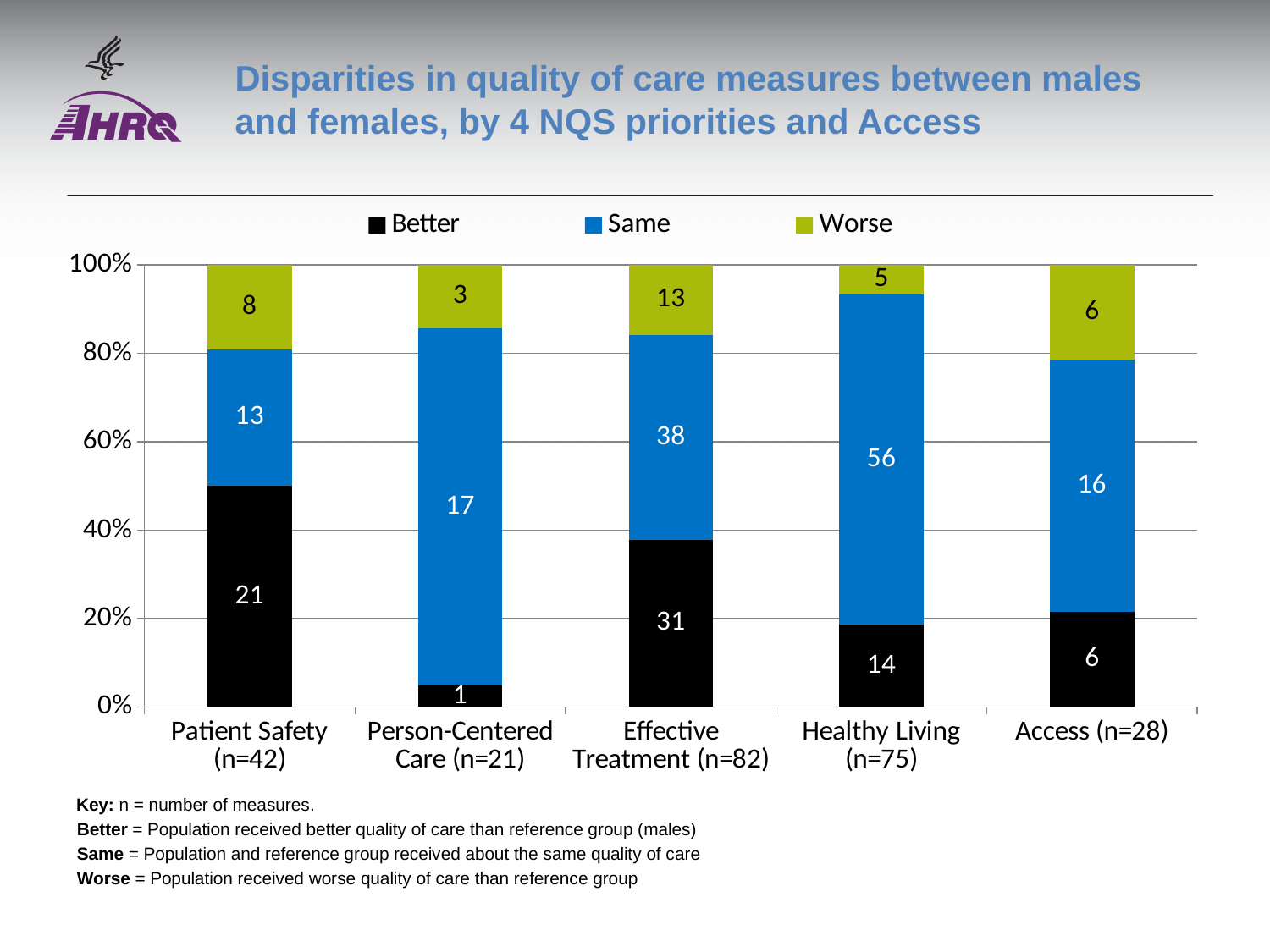
What is the total of the Better, Same and Worse values for Access (n=28)? 28 What is the Worse value for Patient Safety (n=42)? 8 Which category has the highest Same value? Healthy Living (n=75) What is the Better value for Person-Centered Care (n=21)? 1 What is the difference between the Same and Better values for Effective Treatment (n=82)? 7 How many series does the legend list? 3 Which is larger, the Better value for Patient Safety (n=42) or the Better value for Healthy Living (n=75)? Patient Safety (n=42) What is the Better value for Effective Treatment (n=82)? 31 What kind of chart is shown on the slide? Stacked bar chart What is the Same value for Healthy Living (n=75)? 56 How many categories are shown on the x axis? 5 Which category has the lowest Better value? Person-Centered Care (n=21)